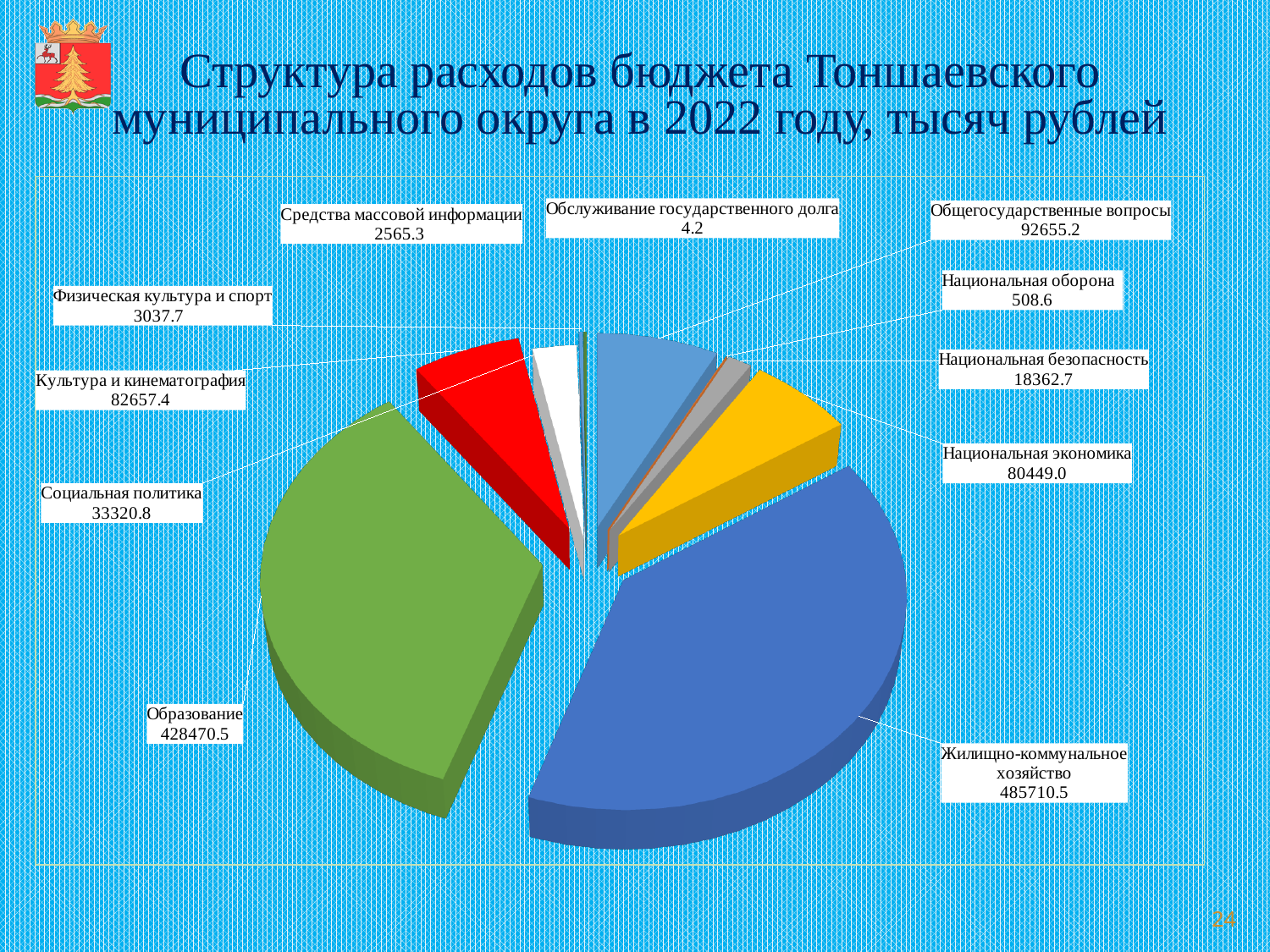
What is the value for Образование? 428470.5 Which category has the largest value in the pie chart? Жилищно-коммунальное хозяйство What is the value for Обслуживание государственного долга? 4.2 What is the value for Национальная безопасность? 18362.7 What is the title of the slide? Структура расходов бюджета Тоншаевского муниципального округа в 2022 году, тысяч рублей Which is larger: Культура и кинематография or Национальная экономика? Культура и кинематография What is the value for Жилищно-коммунальное хозяйство? 485710.5 What type of chart is shown on the slide? Pie chart What is the difference between the values for Общегосударственные вопросы and Культура и кинематография? 9997.8 Which category has the smallest value in the pie chart? Обслуживание государственного долга How many categories are shown in the pie chart? 11 What is the difference between the values for Жилищно-коммунальное хозяйство and Образование? 57240.0